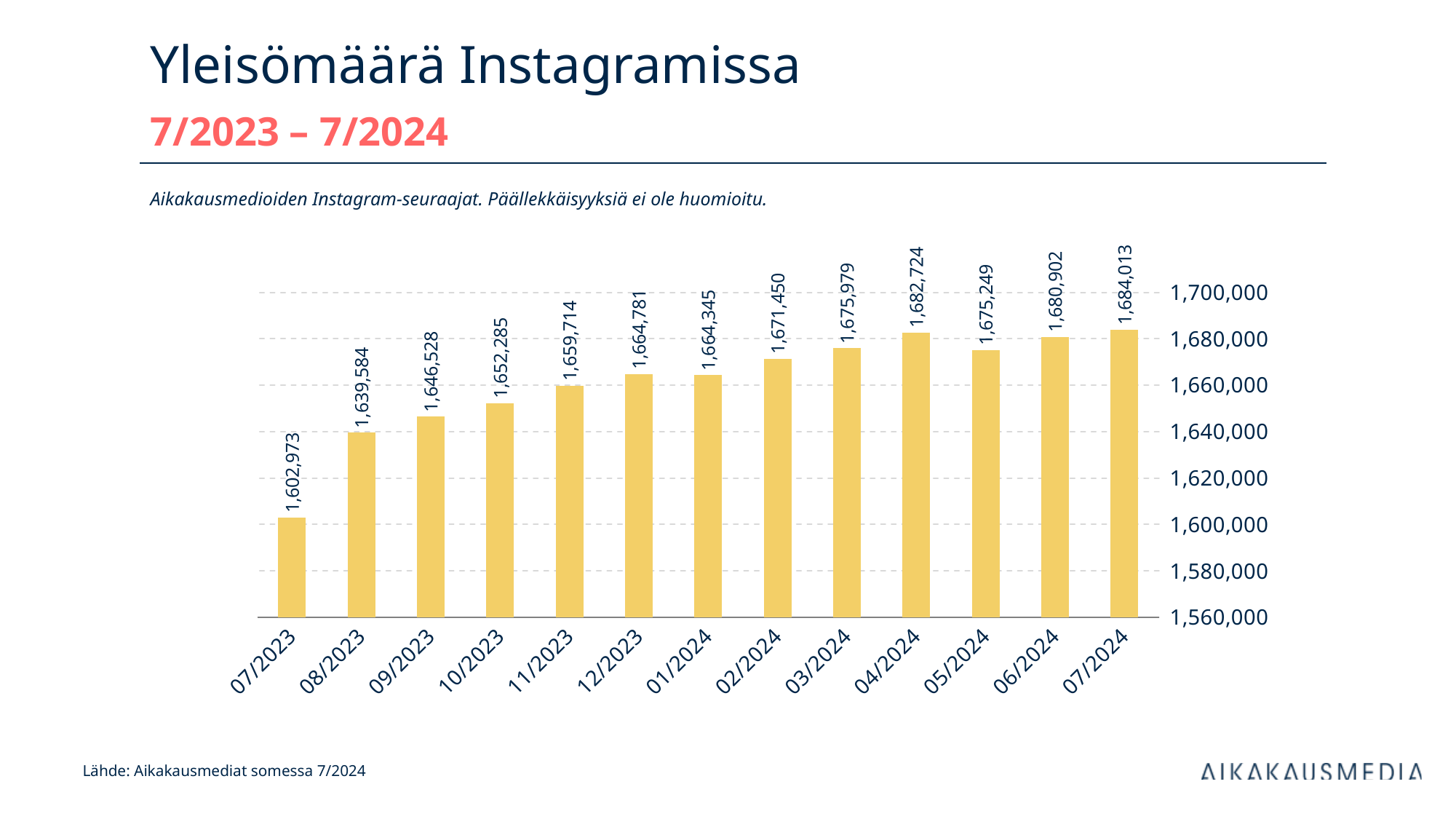
How many months are shown on the x axis? 13 Which month has the highest value? 07/2024 Is the value for 10/2023 greater or less than 1,660,000? less What is the value for 04/2024? 1,682,724 What is the value for 01/2024? 1,664,345 What is the value for 07/2023? 1,602,973 What is the title of the chart? Yleisömäärä Instagramissa What is the difference between the values for 07/2024 and 07/2023? 81,040 What kind of chart is shown on the slide? bar chart What is the difference between the values for 04/2024 and 05/2024? 7,475 Which is larger, the value for 12/2023 or the value for 01/2024? 12/2023 Which month has the lowest value? 07/2023